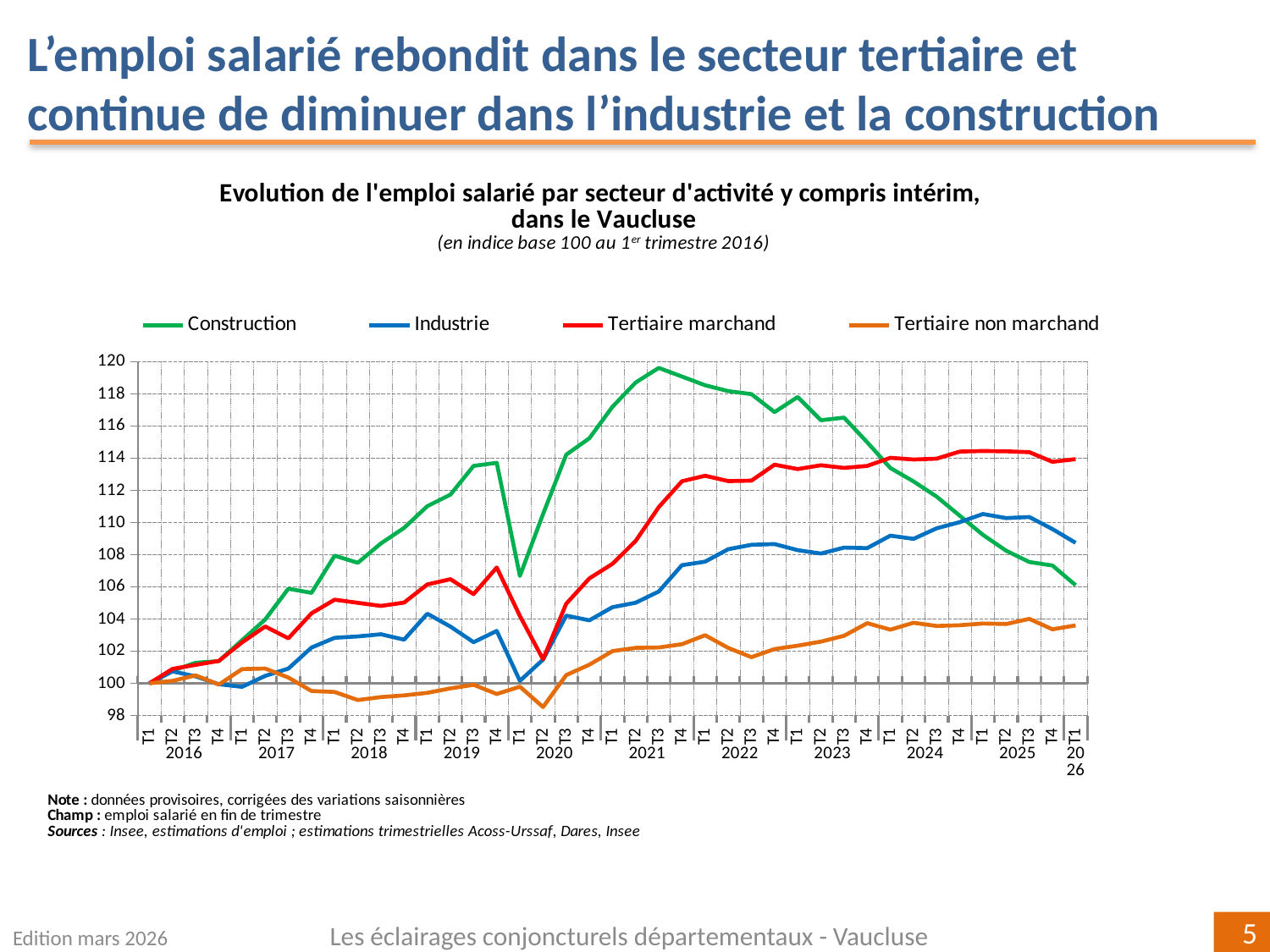
Is the value for Construction at T3 2021 greater or less than 118? greater Which series has the lowest value at T1 2026? Tertiaire non marchand Which series are listed in the legend? Construction, Industrie, Tertiaire marchand, Tertiaire non marchand Does the Construction series rise or fall between T1 2024 and T1 2026? fall What is the index value of all four series at T1 2016? 100 Which series has the highest value at T3 2021? Construction How many series does the legend list? 4 What kind of chart is shown on the slide? line chart Which series has the highest value at T1 2026? Tertiaire marchand Is the value for Tertiaire non marchand at T2 2020 greater or less than 100? less Is the value for Tertiaire marchand at T1 2025 greater or less than 112? greater